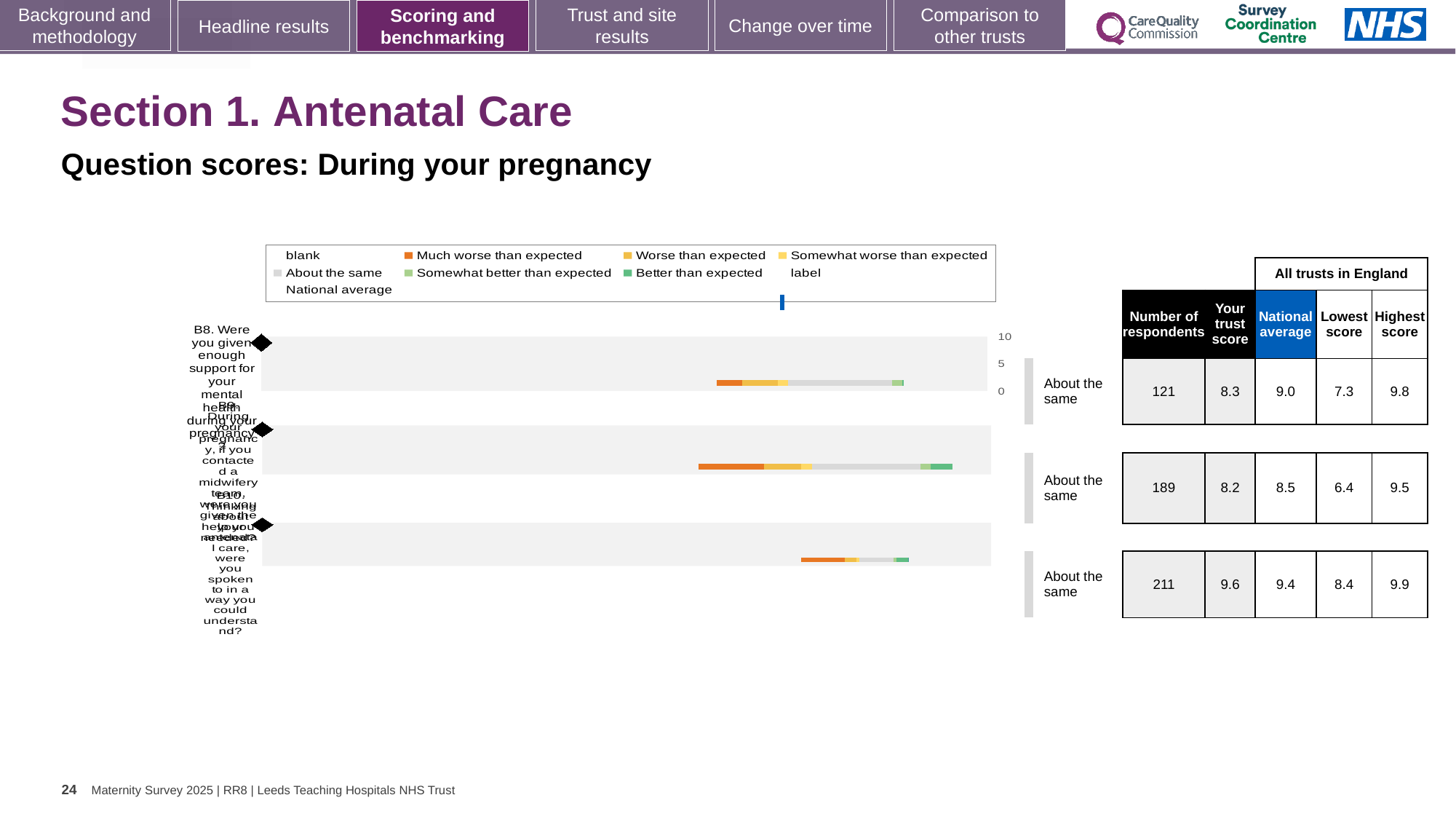
In the table next to the chart, which row has the highest 'Your trust score'? the third row (9.6) What benchmark category is shown beside each of the three bars? About the same How many question bars are plotted in the chart? 3 In the table next to the chart, what is 'Your trust score' for the first row (B8)? 8.3 What kind of chart is shown on the slide? bar chart In the table next to the chart, is the trust score for the third row higher or lower than its national average? higher What is the highest tick value shown on the chart's axis? 10 In the table next to the chart, what is the number of respondents for the first row (B8, support for your mental health during pregnancy)? 121 How many entries does the chart's legend list? 9 In the table next to the chart, what is the highest score among all trusts in England for the second row? 9.5 Which legend entry is shown in dark orange? Much worse than expected In the table next to the chart, what is the difference between the national average and the trust score for the first row (B8)? 0.7